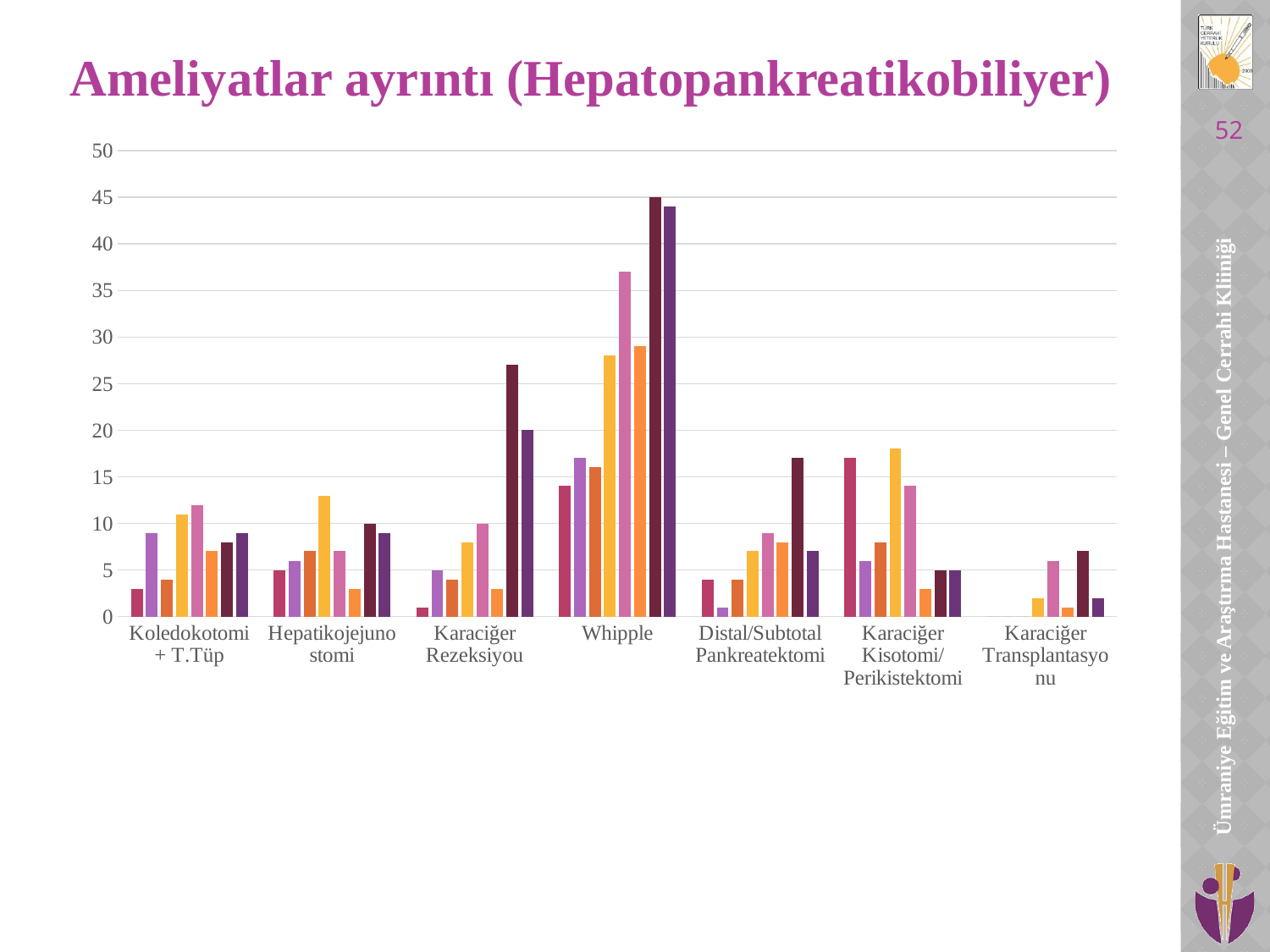
What kind of chart is shown on the slide? bar chart How many operation categories are shown on the x axis? 7 Is the tallest bar for Karaciğer Transplantasyonu greater or less than 10? less Is the tallest bar for Karaciğer Rezeksiyou greater or less than 25? greater Which category has the tallest bar in the chart? Whipple How many bars are in the Whipple group? 8 Which category has a taller maximum bar, Whipple or Karaciğer Rezeksiyou? Whipple What is the highest value shown on the vertical axis? 50 Is the tallest bar for Koledokotomi + T.Tüp greater or less than 15? less